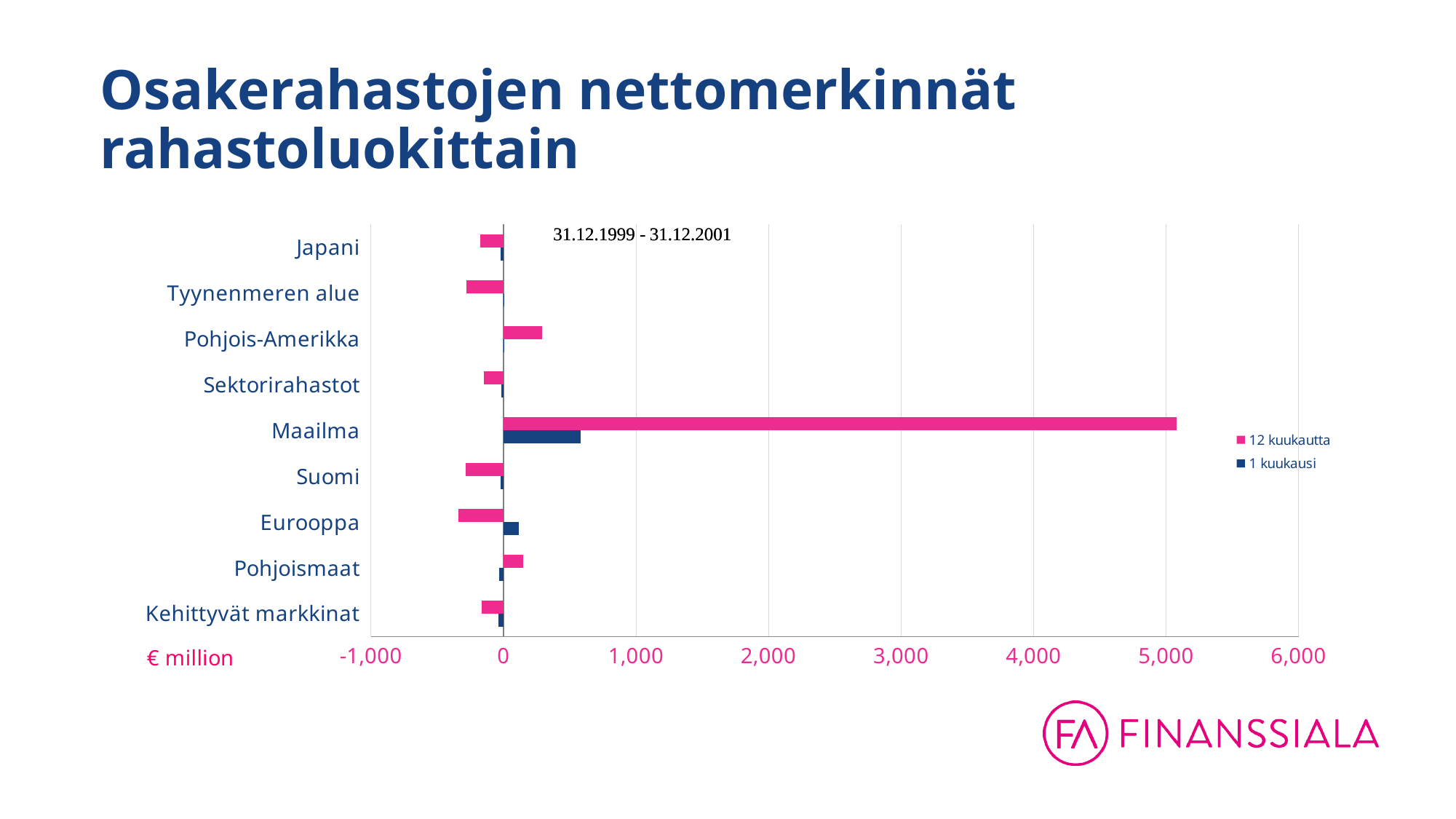
Is the 12 kuukautta value for Maailma greater or less than 4,000? greater What unit label is shown at the bottom left of the chart? € million Which category has the highest 12 kuukautta value? Maailma Which is larger, the 12 kuukautta value for Maailma or the 12 kuukautta value for Pohjois-Amerikka? Maailma Is the 1 kuukausi value for Maailma greater or less than 1,000? less What period is shown in the text inside the chart area? 31.12.1999 - 31.12.2001 How many series does the chart legend list? 2 Which is larger, the 12 kuukautta value for Pohjois-Amerikka or the 12 kuukautta value for Suomi? Pohjois-Amerikka Is the 12 kuukautta value for Pohjois-Amerikka greater or less than 1,000? less What kind of chart is shown on the slide? bar chart How many fund categories are listed on the vertical axis of the chart? 9 Which category has the highest 1 kuukausi value? Maailma